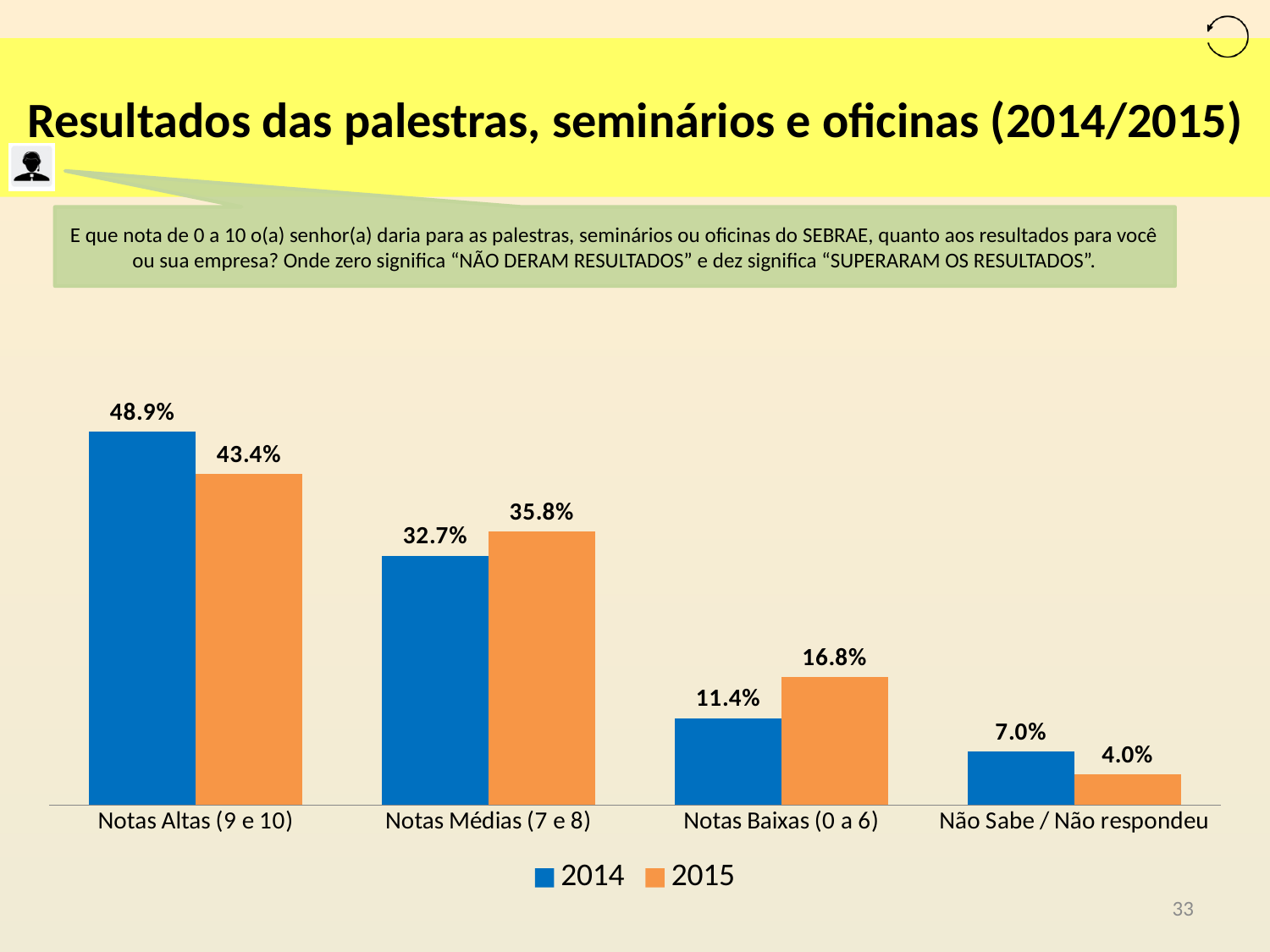
What is the difference between the 2014 and 2015 values for Notas Baixas (0 a 6)? 5.4% What kind of chart is shown on the slide? Bar chart What is the value for Não Sabe / Não respondeu in 2015? 4.0% How many categories are shown on the x axis? 4 How many series does the legend list? 2 Which category has the highest value for 2015? Notas Altas (9 e 10) Which category has the lowest value for 2014? Não Sabe / Não respondeu What is the value for Notas Médias (7 e 8) in 2015? 35.8% Which is larger for Notas Médias (7 e 8): the 2014 value or the 2015 value? 2015 Do the 2014 values rise or fall from left to right across the categories? Fall Which colour represents the 2015 series in the legend? Orange What is the value for Notas Altas (9 e 10) in 2014? 48.9%